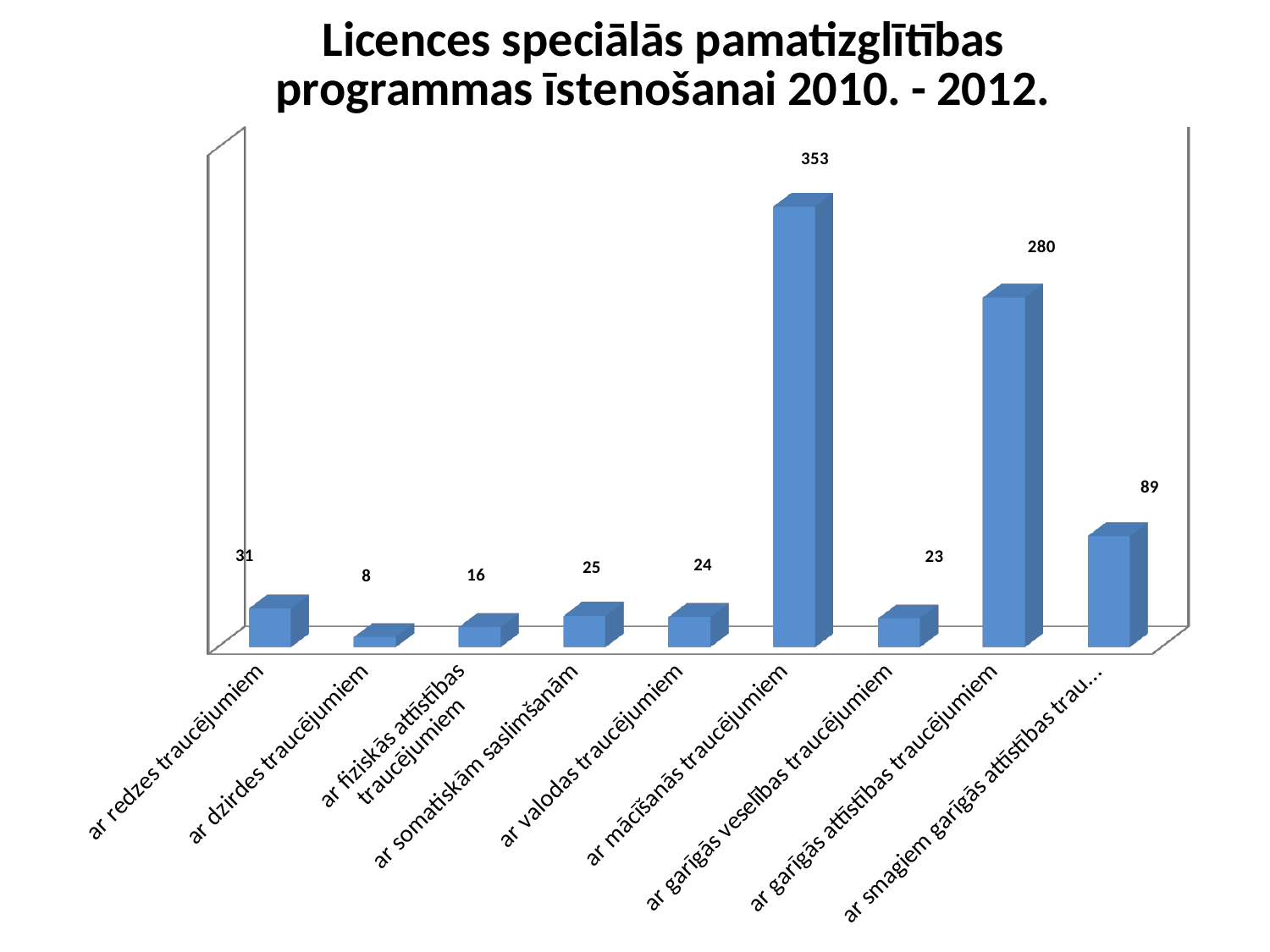
How many categories are shown on the x axis of the chart? 9 What is the difference between the values for "ar mācīšanās traucējumiem" and "ar garīgās attīstības traucējumiem"? 73 What is the value for "ar garīgās attīstības traucējumiem"? 280 What is the value for "ar redzes traucējumiem"? 31 What is the value of the rightmost bar in the chart? 89 What is the value for "ar dzirdes traucējumiem"? 8 Which is larger, the value for "ar somatiskām saslimšanām" or the value for "ar fiziskās attīstības traucējumiem"? ar somatiskām saslimšanām What type of chart is shown on the slide? bar chart What is the title of the chart? Licences speciālās pamatizglītības programmas īstenošanai 2010. - 2012. What is the value for "ar mācīšanās traucējumiem"? 353 Which category has the highest value? ar mācīšanās traucējumiem Which category has the lowest value? ar dzirdes traucējumiem